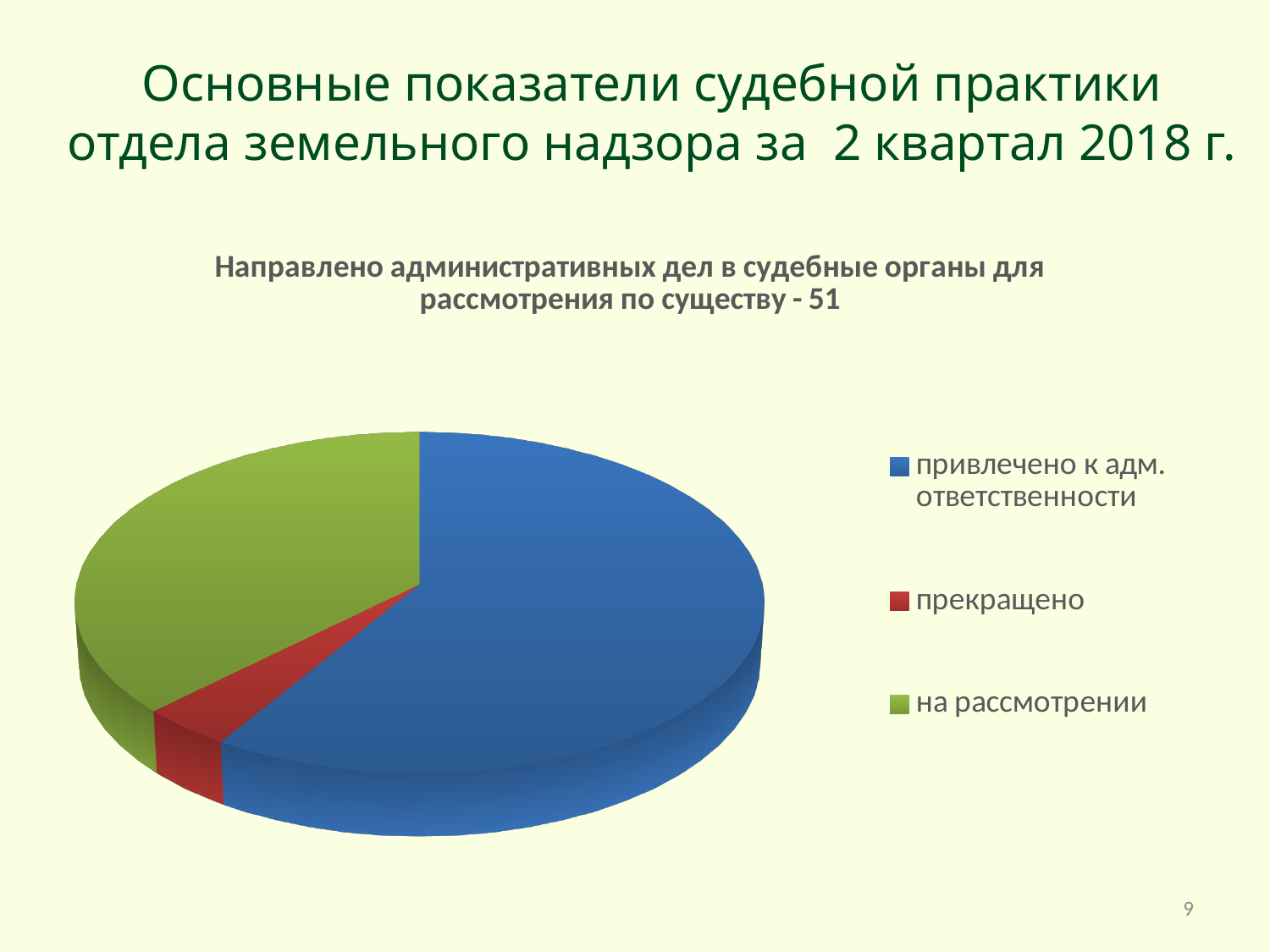
Which category has the largest slice of the pie chart? привлечено к адм. ответственности How many entries does the legend of the pie chart list? 3 How many slices does the pie chart have? 3 Which slice is larger: 'привлечено к адм. ответственности' or 'на рассмотрении'? привлечено к адм. ответственности What colour is the slice for 'прекращено' in the pie chart? red What total number of administrative cases sent to the courts is stated in the chart title? 51 What kind of chart is shown on the slide? pie chart Which slice is larger: 'на рассмотрении' or 'прекращено'? на рассмотрении Which category has the smallest slice of the pie chart? прекращено